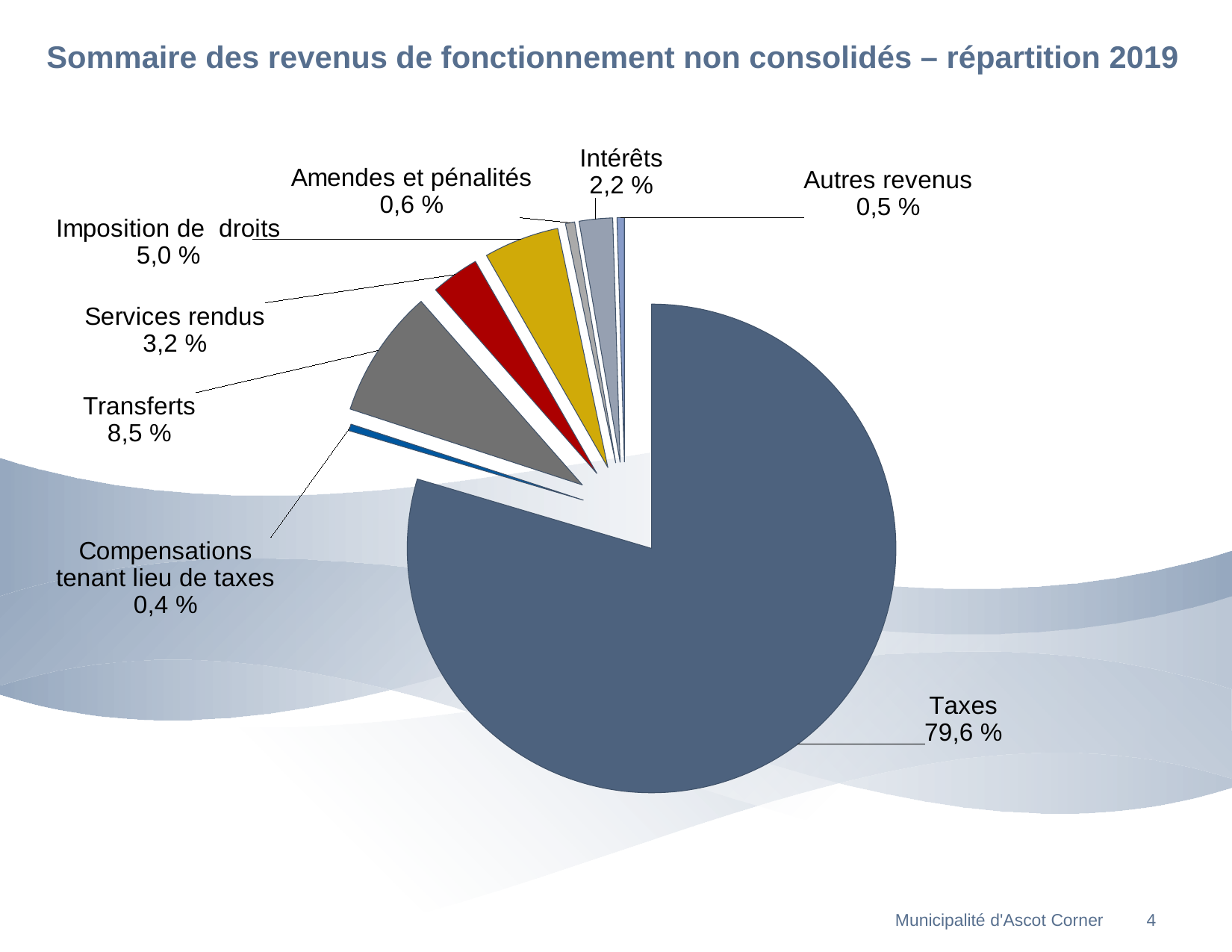
How many categories are shown in the pie chart? 8 What is the value shown for Intérêts? 2,2 % Which category has the smallest share of the pie? Compensations tenant lieu de taxes What is the value shown for Compensations tenant lieu de taxes? 0,4 % What is the value shown for Services rendus? 3,2 % What is the value shown for Transferts? 8,5 % What is the value shown for Imposition de droits? 5,0 % What share of the pie does Taxes represent? 79,6 % What kind of chart is shown on the slide? Pie chart Which category has the largest share of the pie? Taxes Which is larger, Amendes et pénalités or Autres revenus? Amendes et pénalités What is the difference between the shares of Transferts and Imposition de droits? 3,5 %